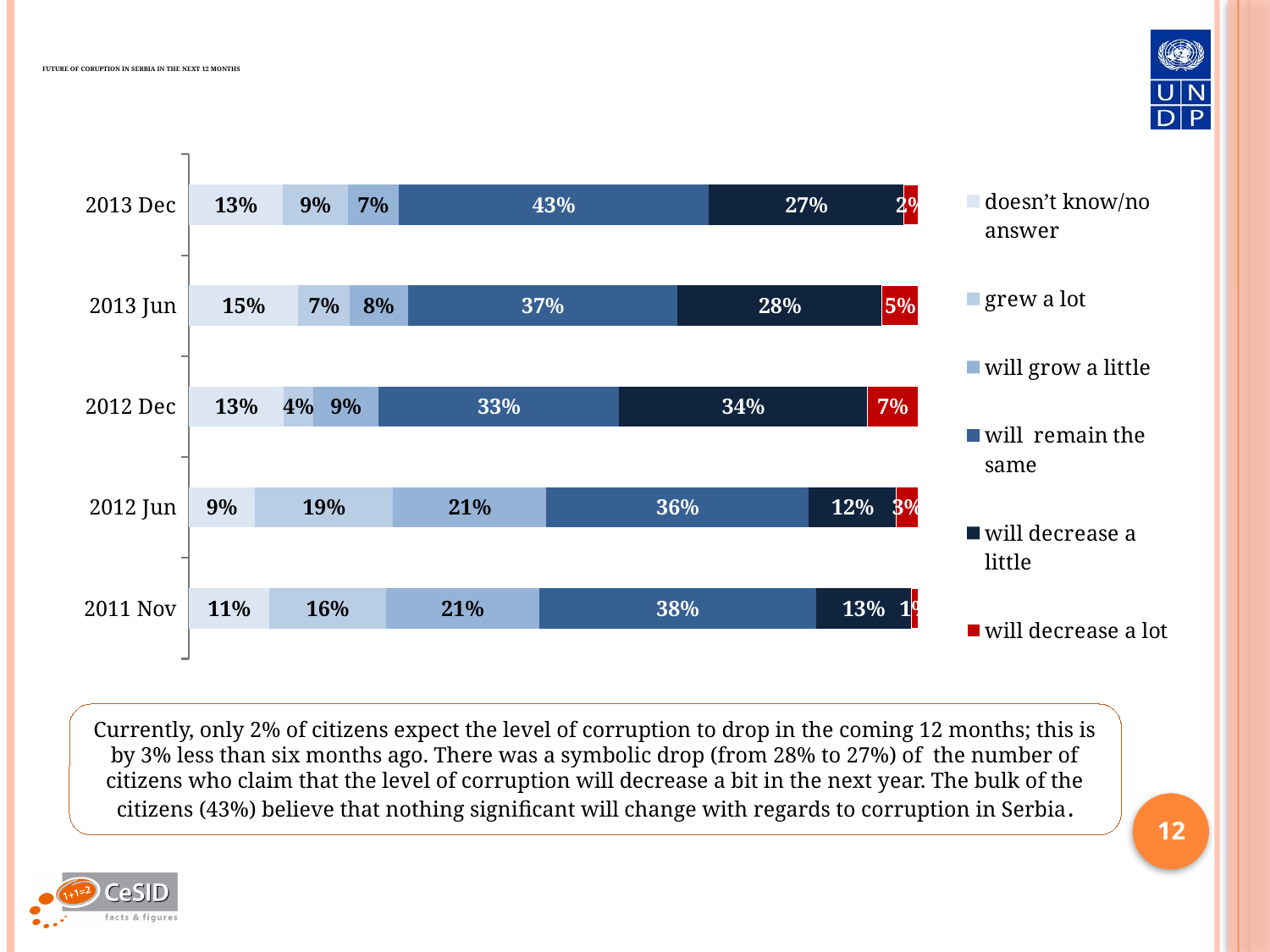
What is the value for 'grew a lot' in 2012 Jun? 19% What is the value for 'doesn't know/no answer' in 2013 Jun? 15% What is the value for 'will decrease a lot' in 2012 Dec? 7% How many series does the legend list? 6 What kind of chart is shown on the slide? stacked bar chart What is the difference between the 'will remain the same' values for 2013 Dec and 2013 Jun? 6% What is the value for 'will remain the same' in 2013 Dec? 43% What is the value for 'will decrease a little' in 2012 Dec? 34% Which is larger: 'will grow a little' in 2011 Nov or 'will grow a little' in 2013 Dec? 2011 Nov Which time period has the highest value for 'will remain the same'? 2013 Dec How many time periods (categories) are shown on the chart? 5 Which time period has the lowest value for 'will decrease a little'? 2012 Jun